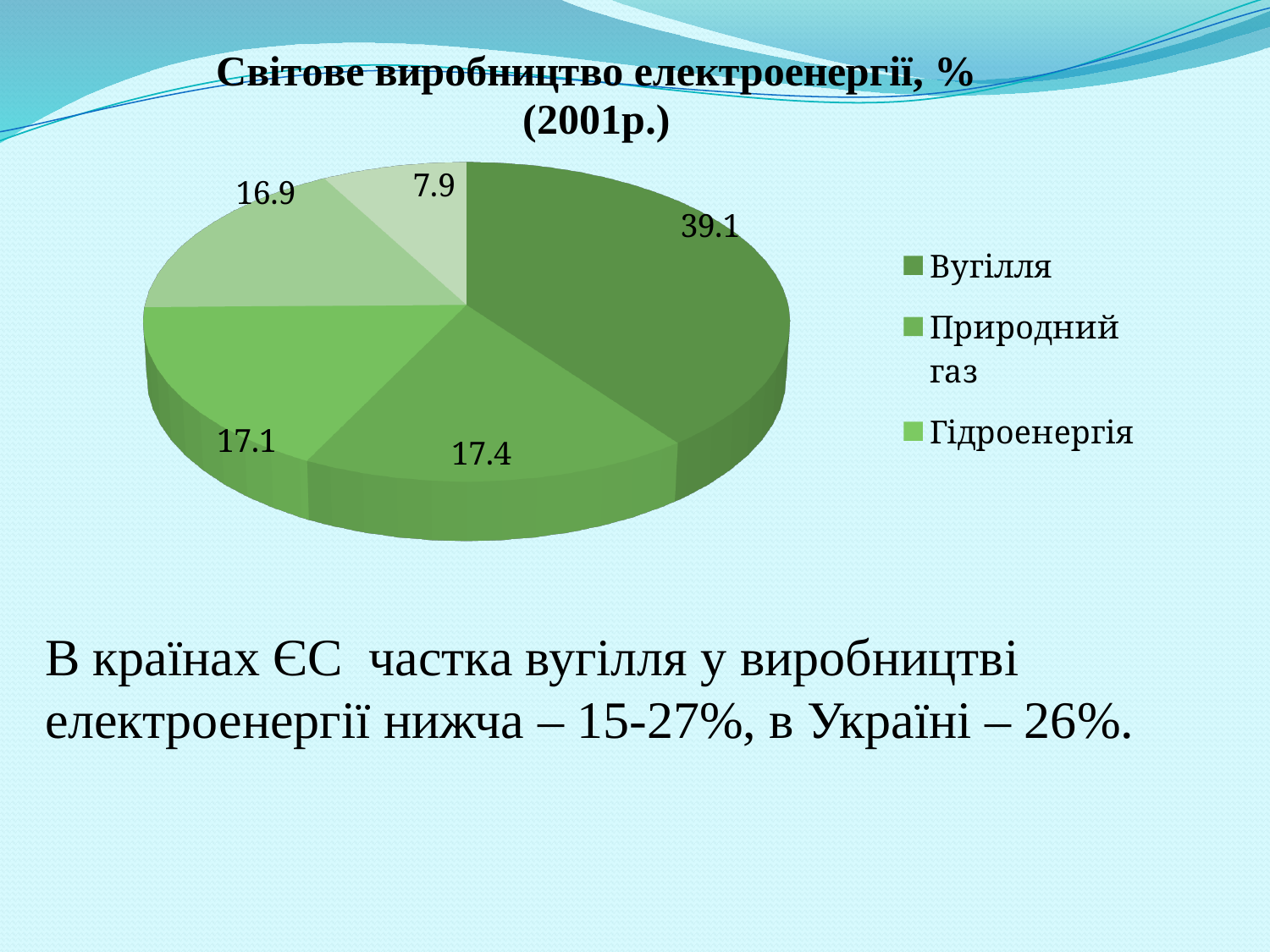
What is the difference between the largest labelled value (39.1) and the smallest labelled value (7.9) on the pie chart? 31.2 What is the value shown for Вугілля in the pie chart? 39.1 What is the value shown for Природний газ in the pie chart? 17.4 What is the value shown for Гідроенергія in the pie chart? 17.1 What kind of chart is shown on the slide? Pie chart How many entries does the chart legend list? 3 What is the smallest value labelled on the pie chart? 7.9 Which is larger, the value for Вугілля or the value for Гідроенергія? Вугілля What is the difference between the values for Вугілля and Природний газ? 21.7 Which legend category has the largest slice of the pie chart? Вугілля How many slices does the pie chart have? 5 What is the title of the chart? Світове виробництво електроенергії, % (2001р.)